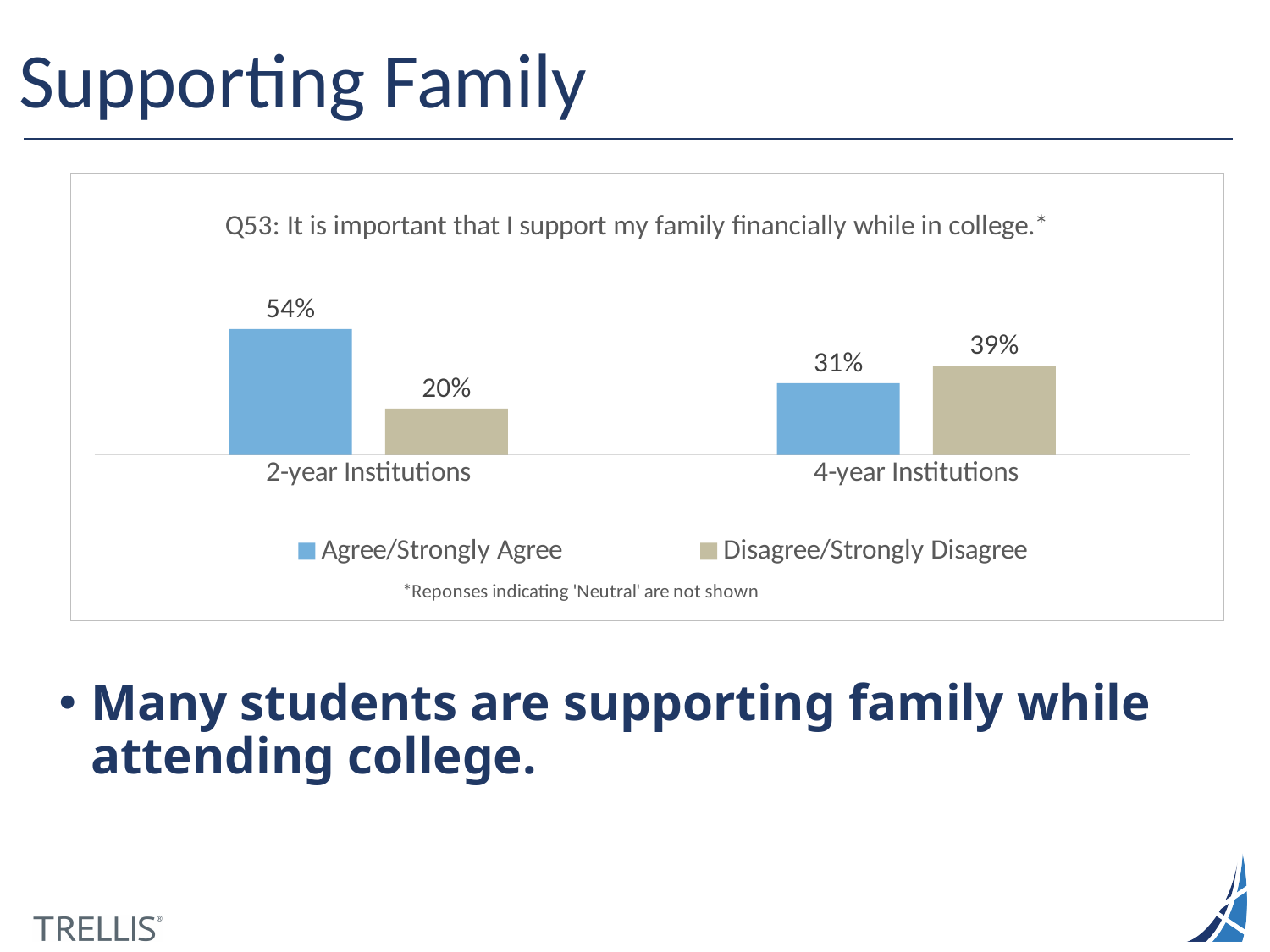
What is the difference between the Agree/Strongly Agree percentages for 2-year and 4-year Institutions? 23 percentage points At 4-year Institutions, which is larger: Agree/Strongly Agree or Disagree/Strongly Disagree? Disagree/Strongly Disagree What is the Disagree/Strongly Disagree value for 2-year Institutions? 20% Which bar shows the lowest value on the chart? Disagree/Strongly Disagree for 2-year Institutions What kind of chart is shown on the slide? Bar chart How many institution categories are shown on the x axis? 2 How many series does the legend list? 2 What is the Agree/Strongly Agree value for 4-year Institutions? 31% What percentage of respondents at 4-year Institutions Disagree/Strongly Disagree? 39% What is the title of the chart? Q53: It is important that I support my family financially while in college.* Which institution type has the higher Agree/Strongly Agree percentage? 2-year Institutions What percentage of respondents at 2-year Institutions Agree/Strongly Agree that it is important to support their family financially while in college? 54%